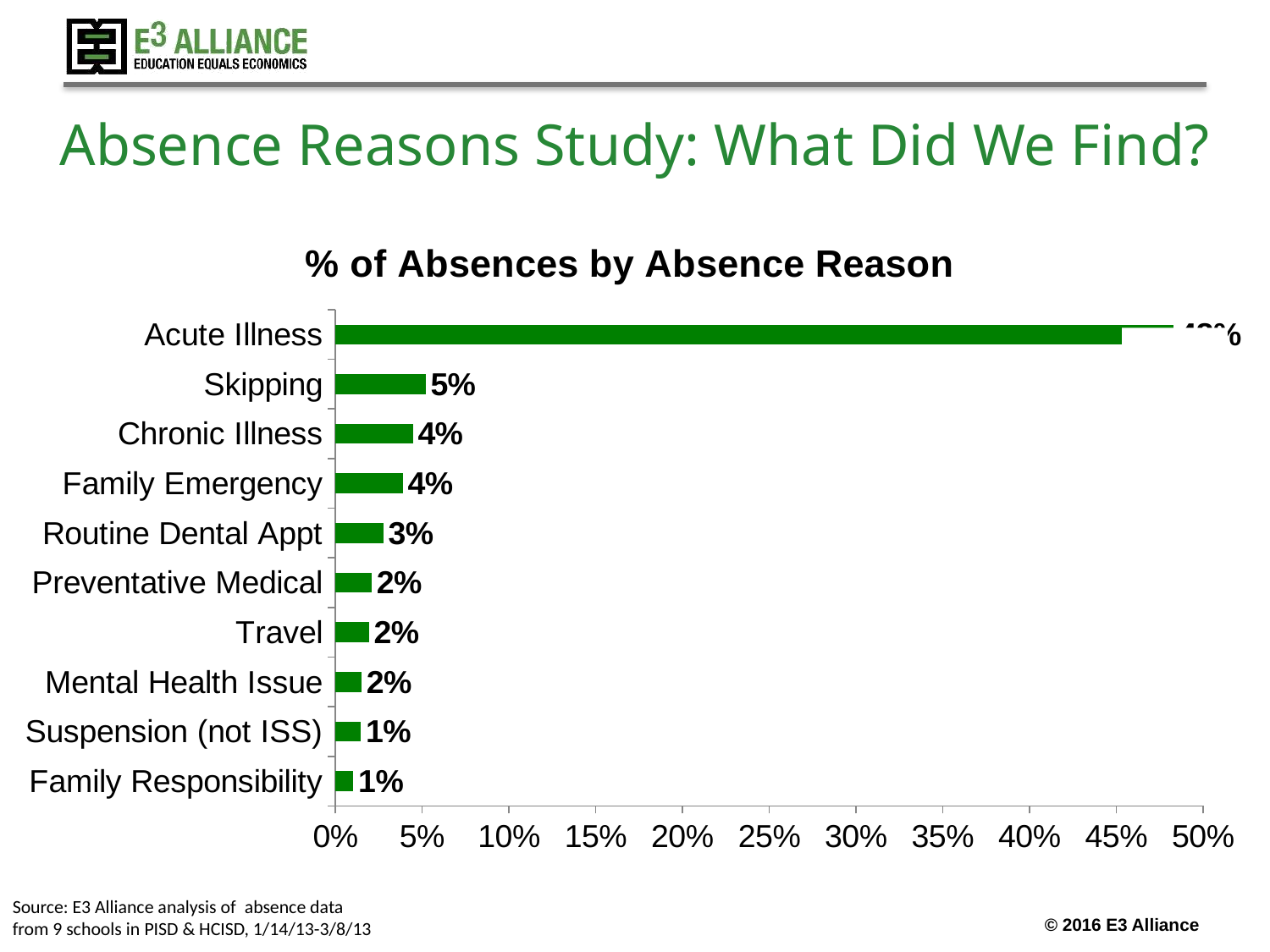
What is the value for Mental Health Issue? 2% What is the difference between the values for Skipping and Routine Dental Appt? 2% What is the value for Routine Dental Appt? 3% What is the value for Skipping? 5% How many absence reasons are shown in the chart? 10 What kind of chart is shown on the slide? Bar chart What is the value for Family Responsibility? 1% What is the title of the chart? % of Absences by Absence Reason Is the value for Acute Illness greater or less than 40%? greater Which is larger, the value for Skipping or the value for Chronic Illness? Skipping Which absence reason has the highest percentage of absences? Acute Illness What is the value for Family Emergency? 4%